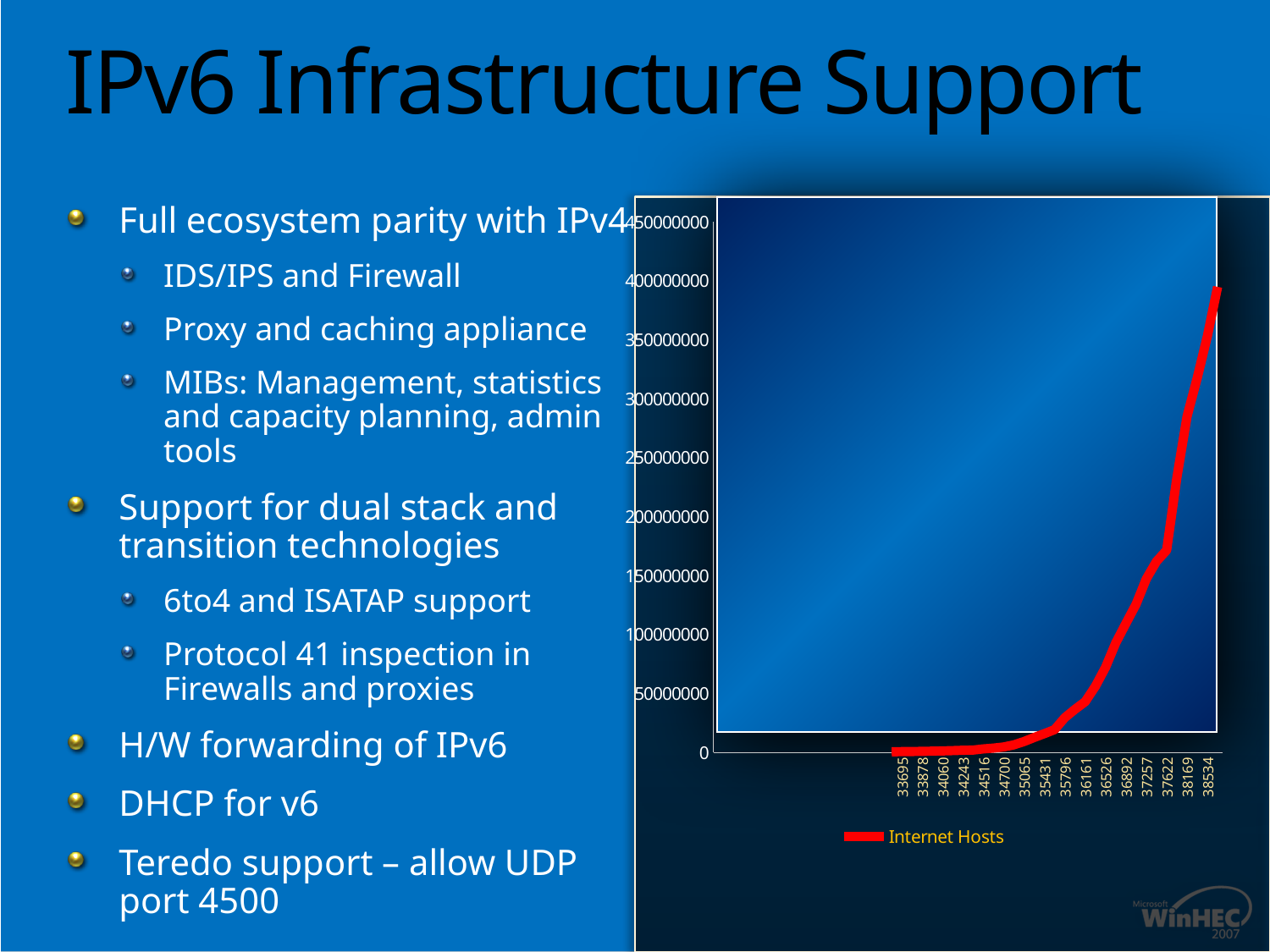
What is the name of the series shown in the chart legend? Internet Hosts Is the Internet Hosts value for 38534 greater or less than 350000000? greater Is the Internet Hosts value for 37622 greater or less than 150000000? greater Which has the larger Internet Hosts value, 38169 or 36892? 38169 Which x-axis category has the highest Internet Hosts value? 38534 How many series does the chart legend list? 1 What kind of chart is shown on the slide? line chart What colour is the Internet Hosts line in the chart? red Do the Internet Hosts values rise or fall along the x axis? rise Is the Internet Hosts value for 35796 greater or less than 50000000? less How many categories are labelled along the x axis of the chart? 16